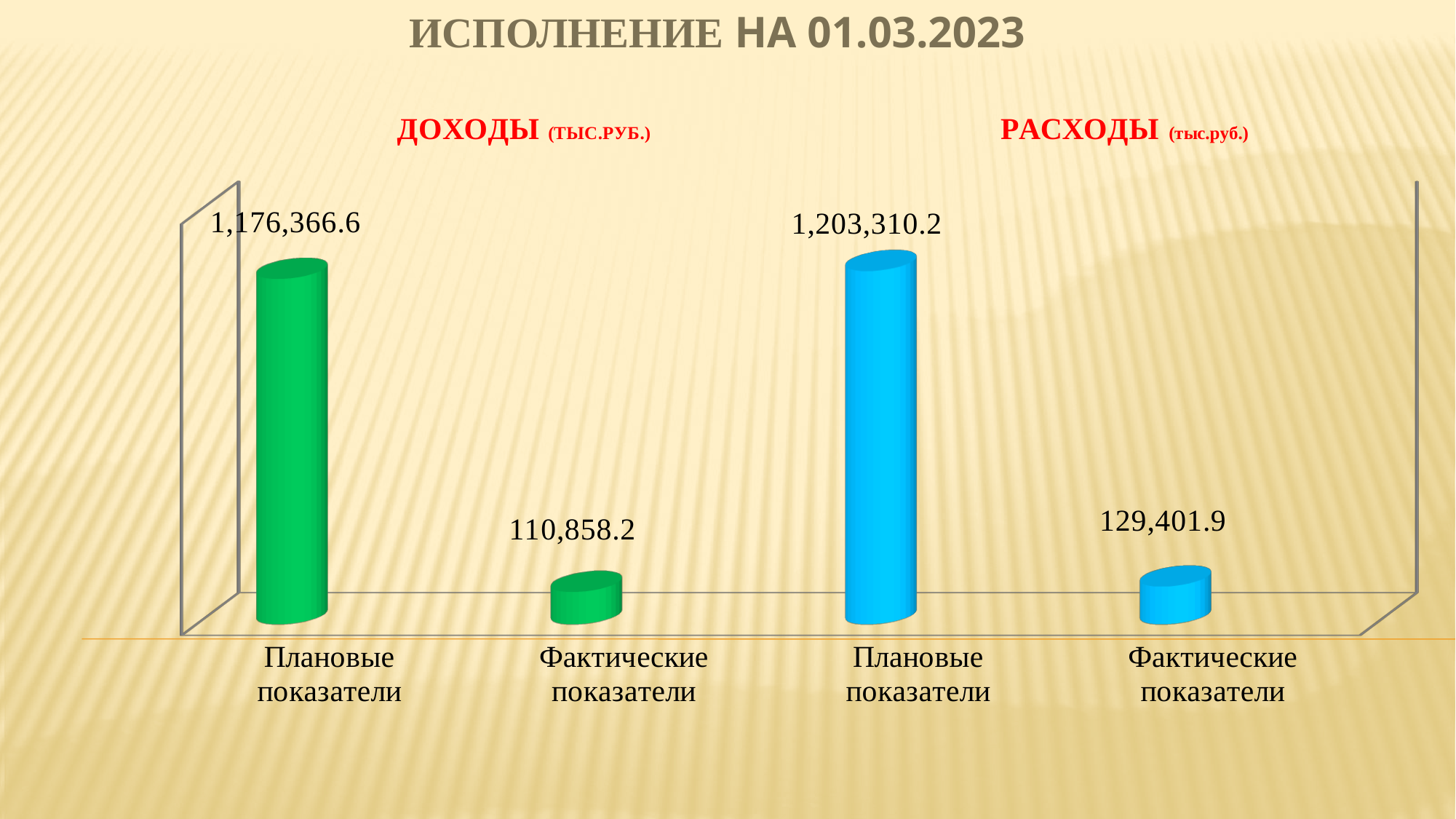
What is the title of the slide? ИСПОЛНЕНИЕ НА 01.03.2023 What type of chart is shown on the slide? Bar chart What is the value of the planned indicators (Плановые показатели) bar under ДОХОДЫ? 1,176,366.6 How many bars are plotted on the chart? 4 What is the value of the planned indicators (Плановые показатели) bar under РАСХОДЫ? 1,203,310.2 Which bar on the chart has the highest value? Плановые показатели (РАСХОДЫ), 1,203,310.2 What is the difference between the planned and actual indicators under РАСХОДЫ? 1,073,908.3 What is the value of the actual indicators (Фактические показатели) bar under ДОХОДЫ? 110,858.2 Which bar on the chart has the lowest value? Фактические показатели (ДОХОДЫ), 110,858.2 Which is larger: the planned indicators for ДОХОДЫ or the planned indicators for РАСХОДЫ? Planned indicators for РАСХОДЫ What is the difference between the planned and actual indicators under ДОХОДЫ? 1,065,508.4 What is the value of the actual indicators (Фактические показатели) bar under РАСХОДЫ? 129,401.9